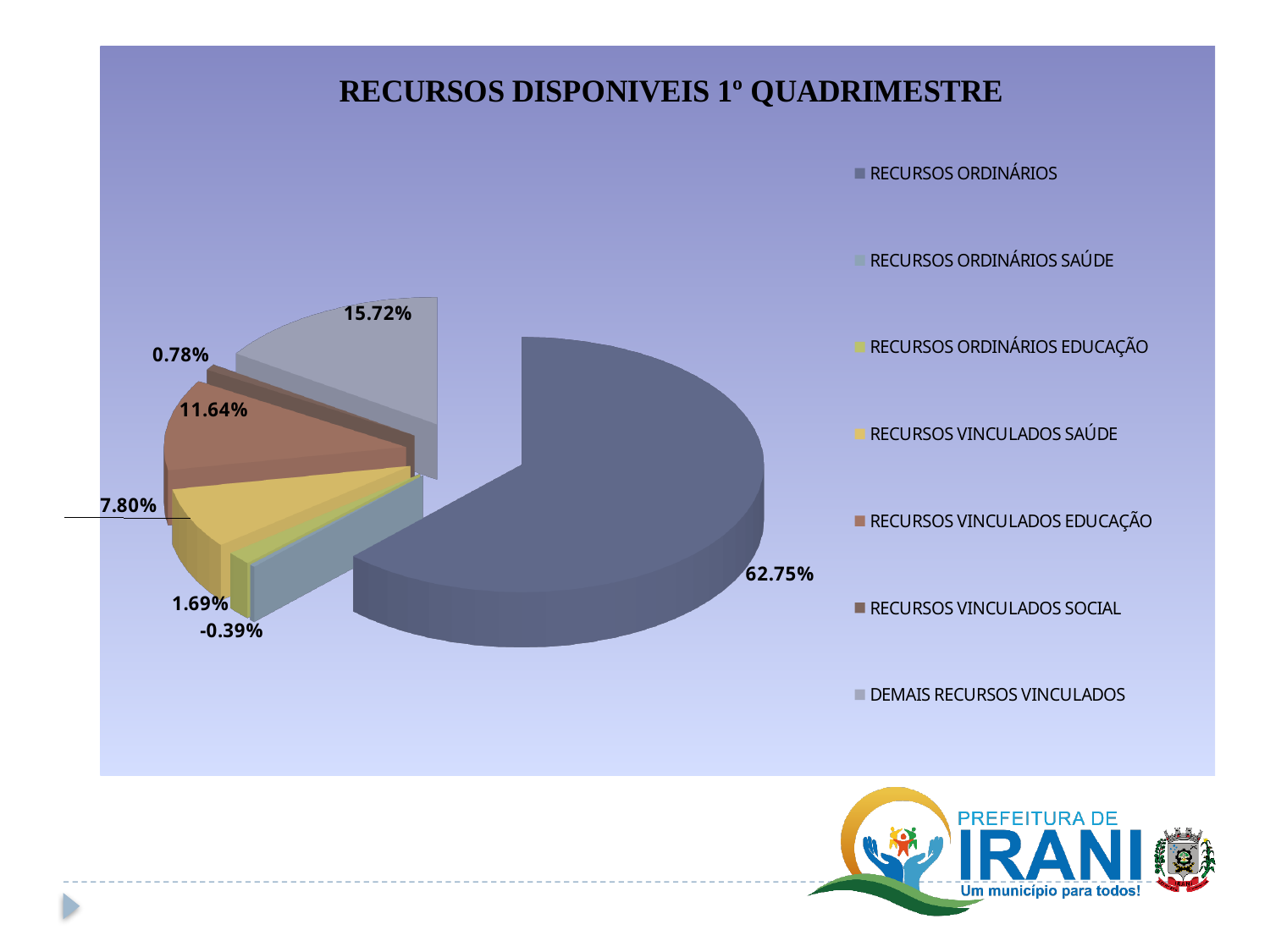
What is the title of the chart? RECURSOS DISPONIVEIS 1º QUADRIMESTRE What is the difference between the share for RECURSOS ORDINÁRIOS and the share for DEMAIS RECURSOS VINCULADOS? 47.03% How many categories does the legend list? 7 What value is shown for RECURSOS VINCULADOS SOCIAL? 0.78% What share of the pie does DEMAIS RECURSOS VINCULADOS represent? 15.72% What share of the pie does RECURSOS VINCULADOS SAÚDE represent? 7.80% What share of the pie does RECURSOS ORDINÁRIOS represent? 62.75% Which is larger, the slice for DEMAIS RECURSOS VINCULADOS or the slice for RECURSOS VINCULADOS EDUCAÇÃO? DEMAIS RECURSOS VINCULADOS What is the lowest value labelled on the chart? -0.39% Which category has the largest slice of the pie? RECURSOS ORDINÁRIOS What type of chart is shown on the slide? pie chart